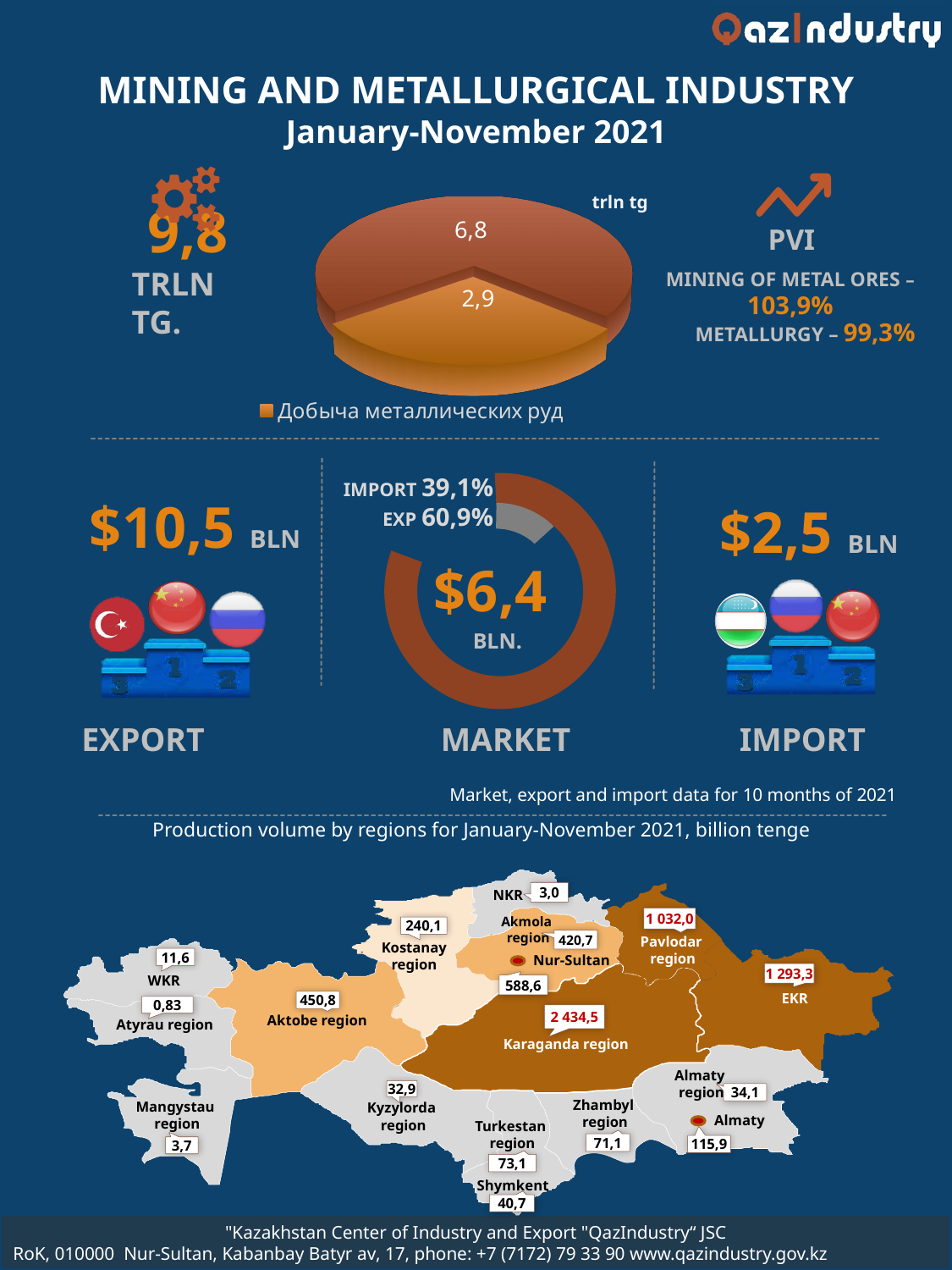
In the MARKET donut chart, what share is labelled as import? 39,1% In the pie chart at the top of the slide, what is the value of the larger slice? 6,8 What kind of chart is the chart at the top of the slide showing 6,8 and 2,9 trln tg? pie chart In the pie chart at the top of the slide, what is the value of the smaller slice? 2,9 On the map of production volume by regions, what is the value for Pavlodar region? 1 032,0 In the pie chart at the top of the slide, what is the difference between the two slices? 3,9 On the map of production volume by regions, which region has the lowest value? Atyrau region In the MARKET donut chart, what share is labelled as export? 60,9% On the map of production volume by regions, which region has the highest value? Karaganda region On the map of production volume by regions, what is the value for EKR? 1 293,3 On the map of production volume by regions, which is larger, Aktobe region or Akmola region? Aktobe region In the MARKET donut chart, which is larger, the import share or the export share? export